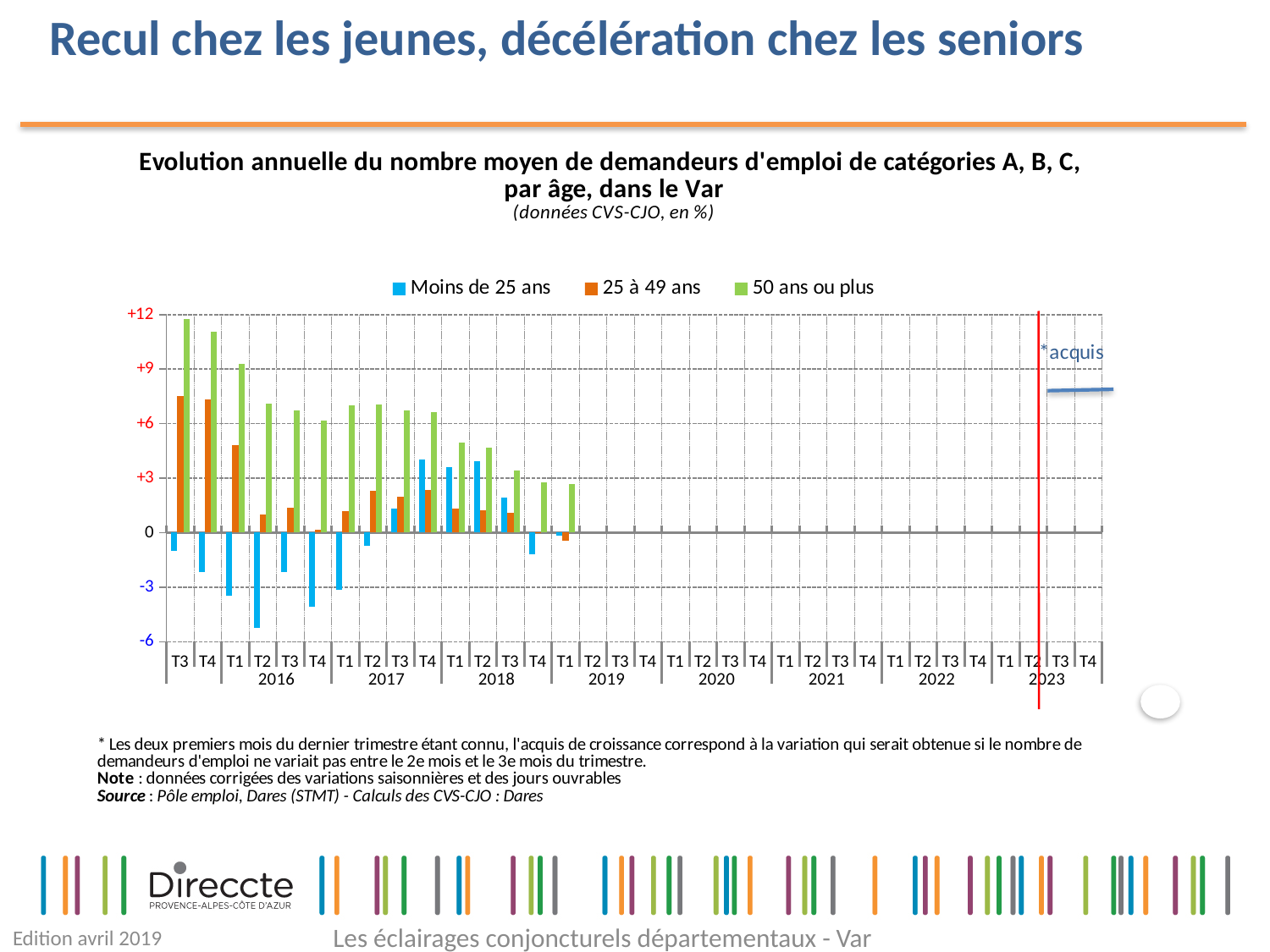
Does the 50 ans ou plus series generally rise or fall from T3 2015 to T1 2019? fall Which age group has the highest value in T3 2015? 50 ans ou plus Is the value for 50 ans ou plus in T1 2019 greater or less than +3? less In which quarter does the 50 ans ou plus series reach its highest value? T3 2015 What are the three series named in the chart legend? Moins de 25 ans, 25 à 49 ans, 50 ans ou plus Is the value for 50 ans ou plus in T3 2015 greater or less than +9? greater How many series does the chart legend list? 3 In T1 2016, which is larger: the value for 25 à 49 ans or the value for 50 ans ou plus? 50 ans ou plus What kind of chart is shown on the slide? bar chart In which quarter does the Moins de 25 ans series reach its lowest value? T2 2016 Is the value for 25 à 49 ans in T3 2015 greater or less than +6? greater